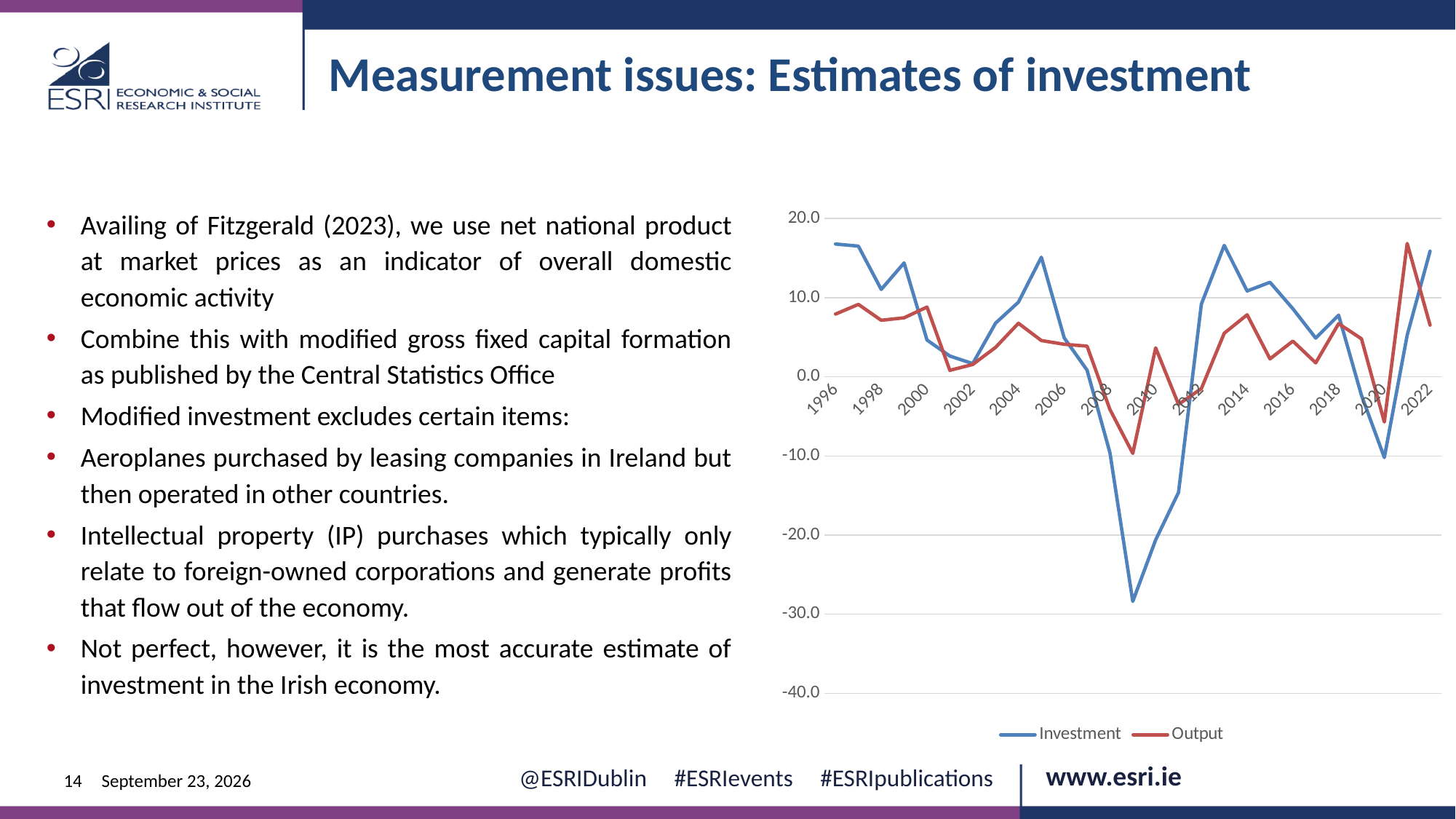
How many series does the chart's legend list? 2 What are the two series named in the chart's legend? Investment and Output In which year does the Investment line reach its lowest value? 2009 Is the value for Output in 2021 greater or less than 10.0? greater Is the value for Investment in 1996 greater or less than 10.0? greater Is the value for Investment in 2009 greater or less than -20.0? less What kind of chart is shown on the slide? line chart Does the Investment line rise or fall between 2006 and 2009? fall In 2009, which series has the higher value, Investment or Output? Output Which colour is used for the Investment line in the chart? blue In which year does the Output line reach its highest value? 2021